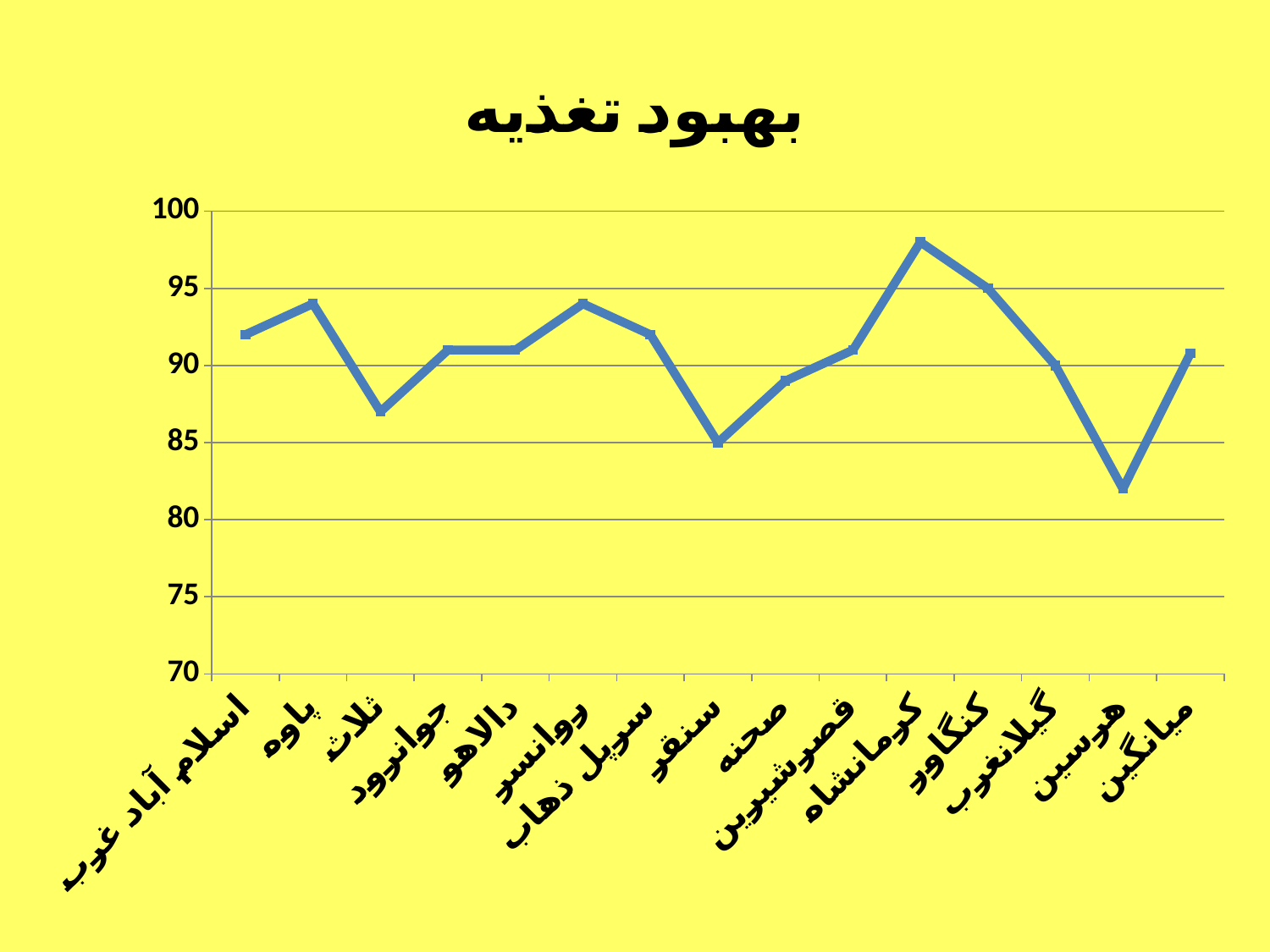
What kind of chart is shown on the slide? line chart Which has the larger value, کرمانشاه or هرسین? کرمانشاه Is the value for پاوه greater or less than 90? greater How many categories are plotted along the x axis? 15 Is the value for هرسین greater or less than 85? less Do the values rise or fall from کرمانشاه to هرسین? fall Is the value for ثلاث greater or less than 90? less Which has the larger value, پاوه or ثلاث? پاوه Which category has the highest value? کرمانشاه Which category has the lowest value? هرسین What is the title of the chart? بهبود تغذیه